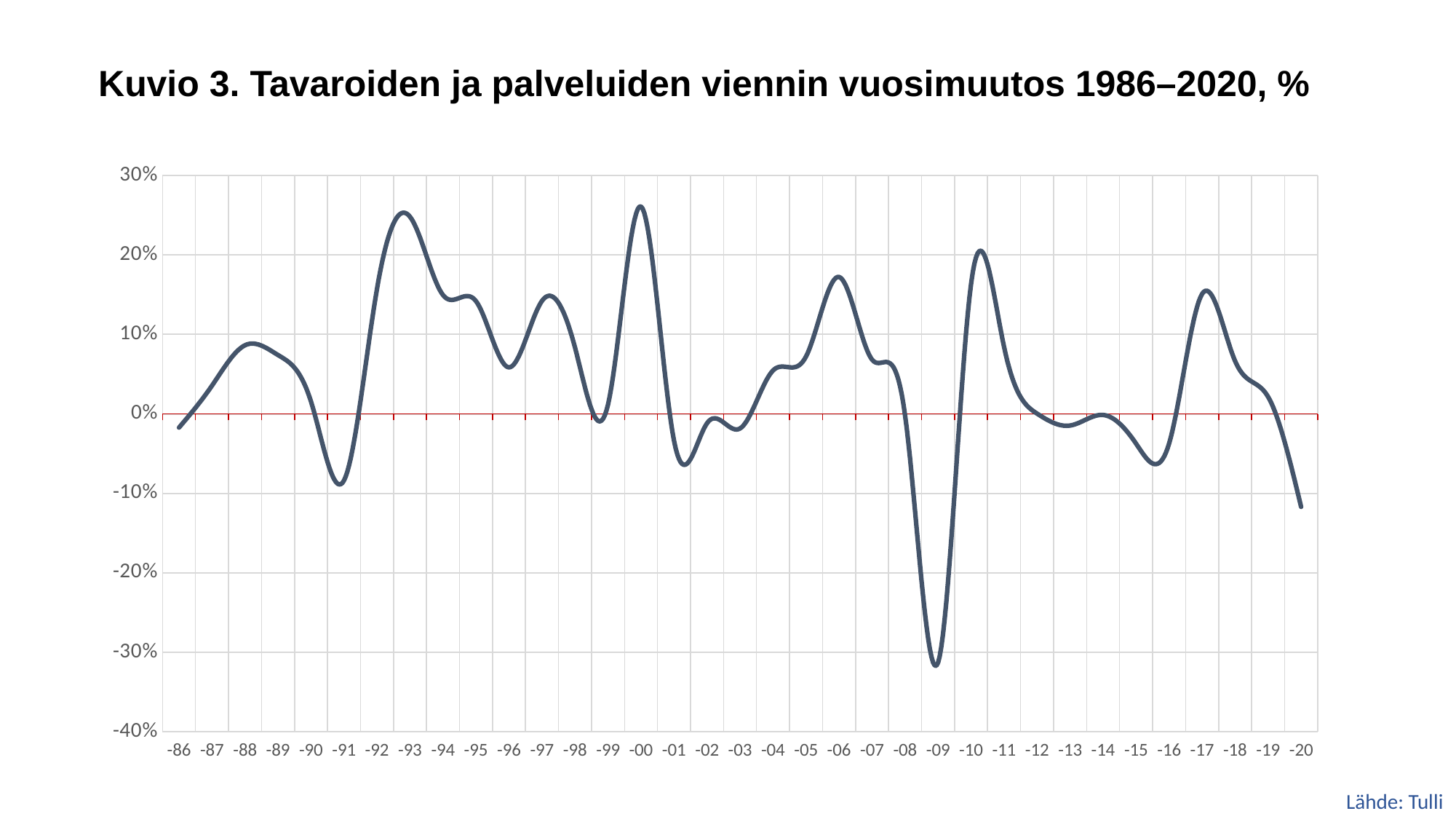
Is the value for -09 greater or less than -30%? less Is the value for -93 greater or less than 20%? greater What source is cited at the bottom of the slide? Tulli Is the value for -20 greater or less than -10%? less How many years are plotted on the x axis? 35 What kind of chart is shown on the slide? line chart Which is larger, the value for -93 or the value for -88? -93 Which is larger, the value for -09 or the value for -20? -20 Which year has the lowest value on the chart? -09 Do the values rise or fall from -17 to -20? fall